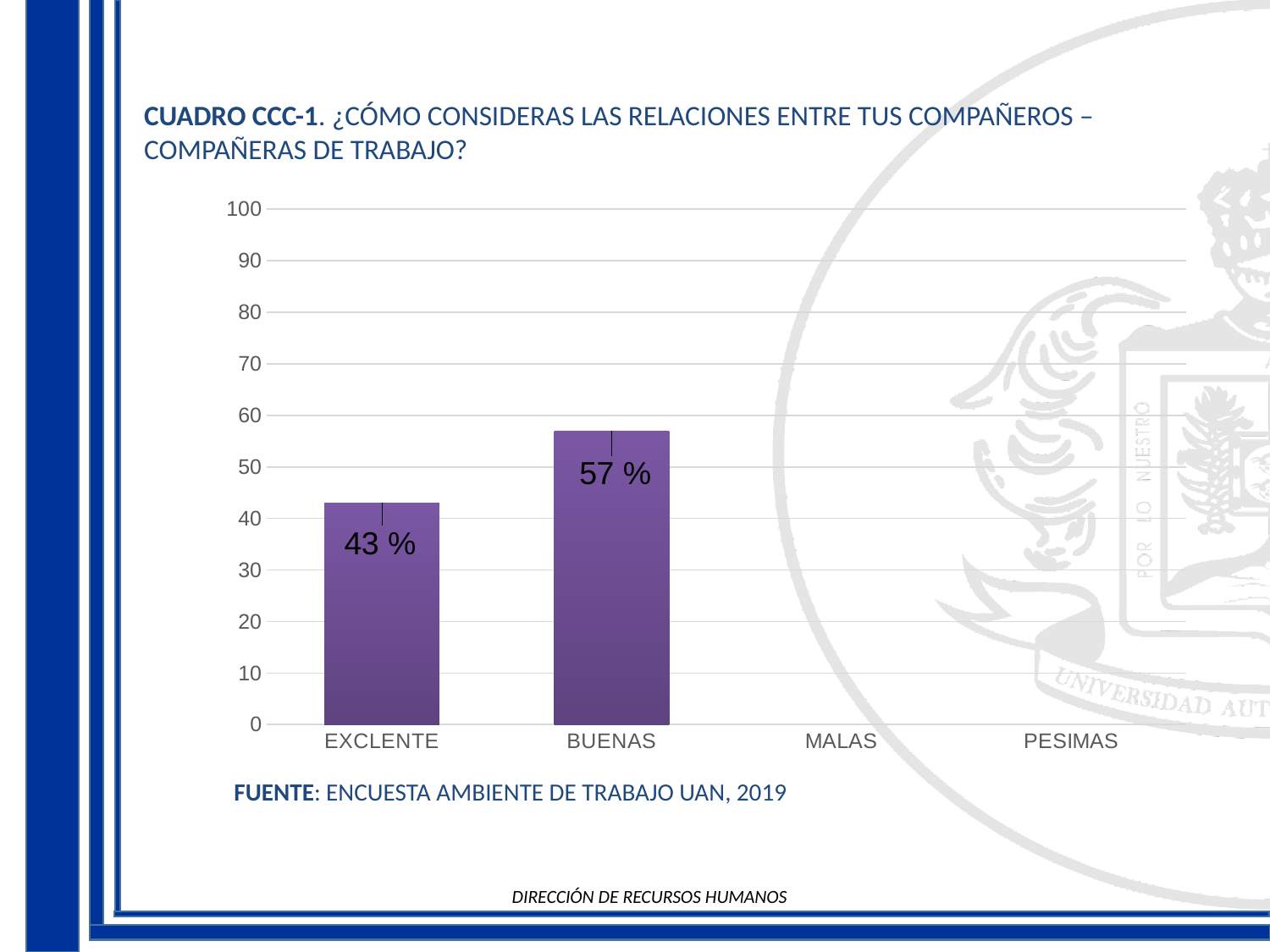
What is the source cited below the chart? ENCUESTA AMBIENTE DE TRABAJO UAN, 2019 What is the value for BUENAS? 57 % Which category has the highest value? BUENAS How many categories are shown on the x axis? 4 Is the value for EXCLENTE greater or less than 50? less What is the difference between the values for BUENAS and EXCLENTE? 14 % What is the total of the values for EXCLENTE and BUENAS? 100 % What kind of chart is shown on the slide? bar chart What is the highest value shown on the y axis? 100 What is the value for EXCLENTE? 43 % Is the value for BUENAS greater or less than 50? greater Which is larger, the value for EXCLENTE or the value for BUENAS? BUENAS